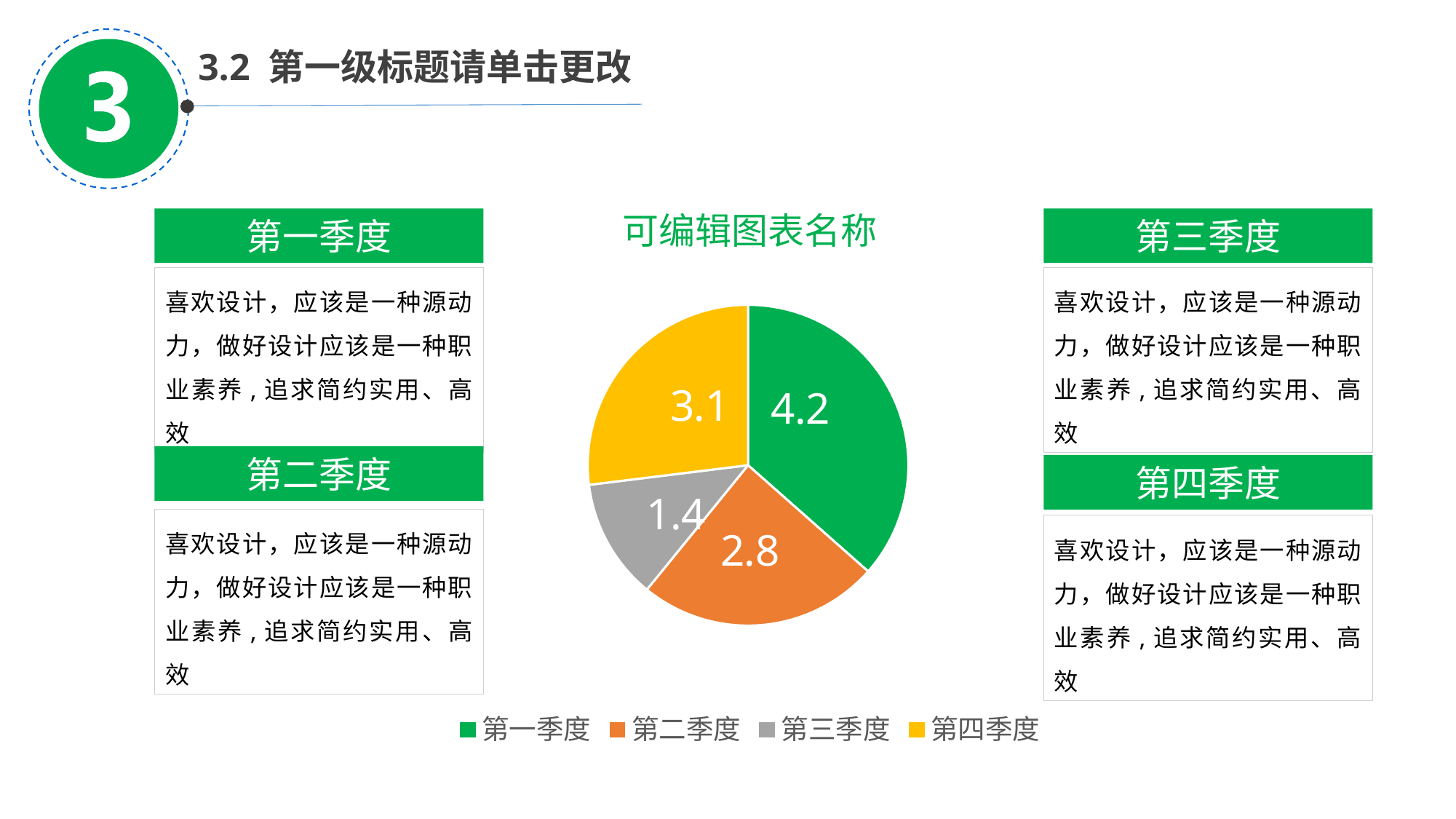
What is the difference between the values for 第一季度 and 第二季度? 1.4 Which category has the smallest slice in the pie chart? 第三季度 Which category has the largest slice in the pie chart? 第一季度 Which is larger, the value for 第四季度 or the value for 第二季度? 第四季度 What type of chart is shown on the slide? pie chart What is the title of the chart? 可编辑图表名称 What colour is the slice for 第四季度? yellow What is the value for 第一季度 in the pie chart? 4.2 How many slices does the pie chart have? 4 What is the value for 第二季度 in the pie chart? 2.8 What is the value for 第三季度 in the pie chart? 1.4 What is the value for 第四季度 in the pie chart? 3.1